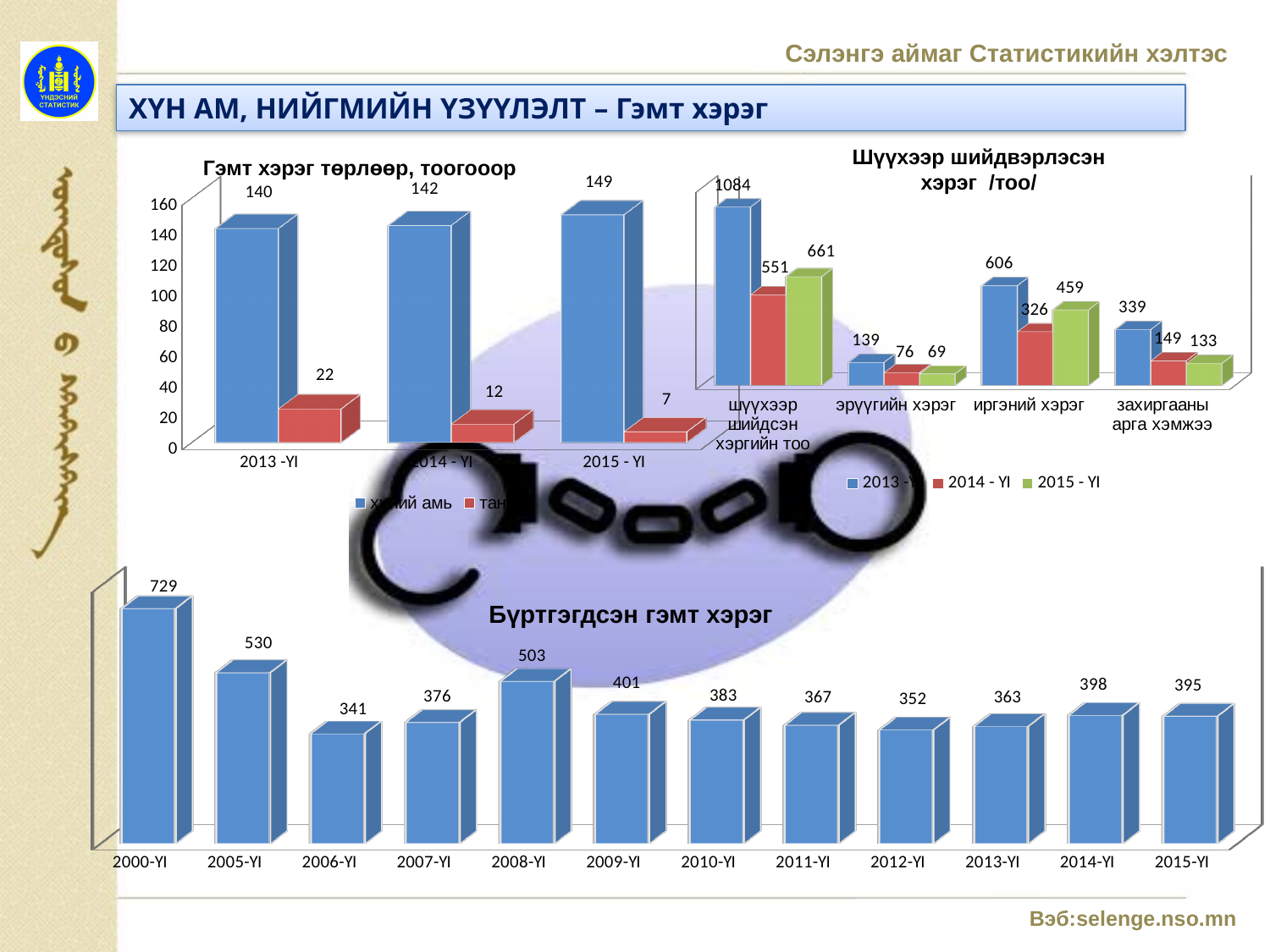
In the 'Шүүхээр шийдвэрлэсэн хэрэг /тоо/' chart, what is the 2013-YI value for 'иргэний хэрэг'? 606 In the 'Шүүхээр шийдвэрлэсэн хэрэг /тоо/' chart, which is larger for 'захиргааны арга хэмжээ': the 2014-YI value or the 2015-YI value? 2014-YI In the 'Бүртгэгдсэн гэмт хэрэг' chart, which year has the lowest value? 2006-YI In the 'Бүртгэгдсэн гэмт хэрэг' chart, what is the value for 2008-YI? 503 In the 'Шүүхээр шийдвэрлэсэн хэрэг /тоо/' chart, how many series does the legend list? 3 In the 'Шүүхээр шийдвэрлэсэн хэрэг /тоо/' chart, what is the 2015-YI value for 'эрүүгийн хэрэг'? 69 In the 'Гэмт хэрэг төрлөөр, тоогооор' chart, do the values of the blue series rise or fall from 2013-YI to 2015-YI? rise In the 'Бүртгэгдсэн гэмт хэрэг' chart, which year has the highest value? 2000-YI In the 'Бүртгэгдсэн гэмт хэрэг' chart, what is the difference between the values for 2000-YI and 2005-YI? 199 What kind of chart is 'Гэмт хэрэг төрлөөр, тоогооор'? bar chart In the 'Бүртгэгдсэн гэмт хэрэг' chart, how many years are shown on the x axis? 12 In the 'Гэмт хэрэг төрлөөр, тоогооор' chart, what is the value of the red bar for 2013-YI? 22